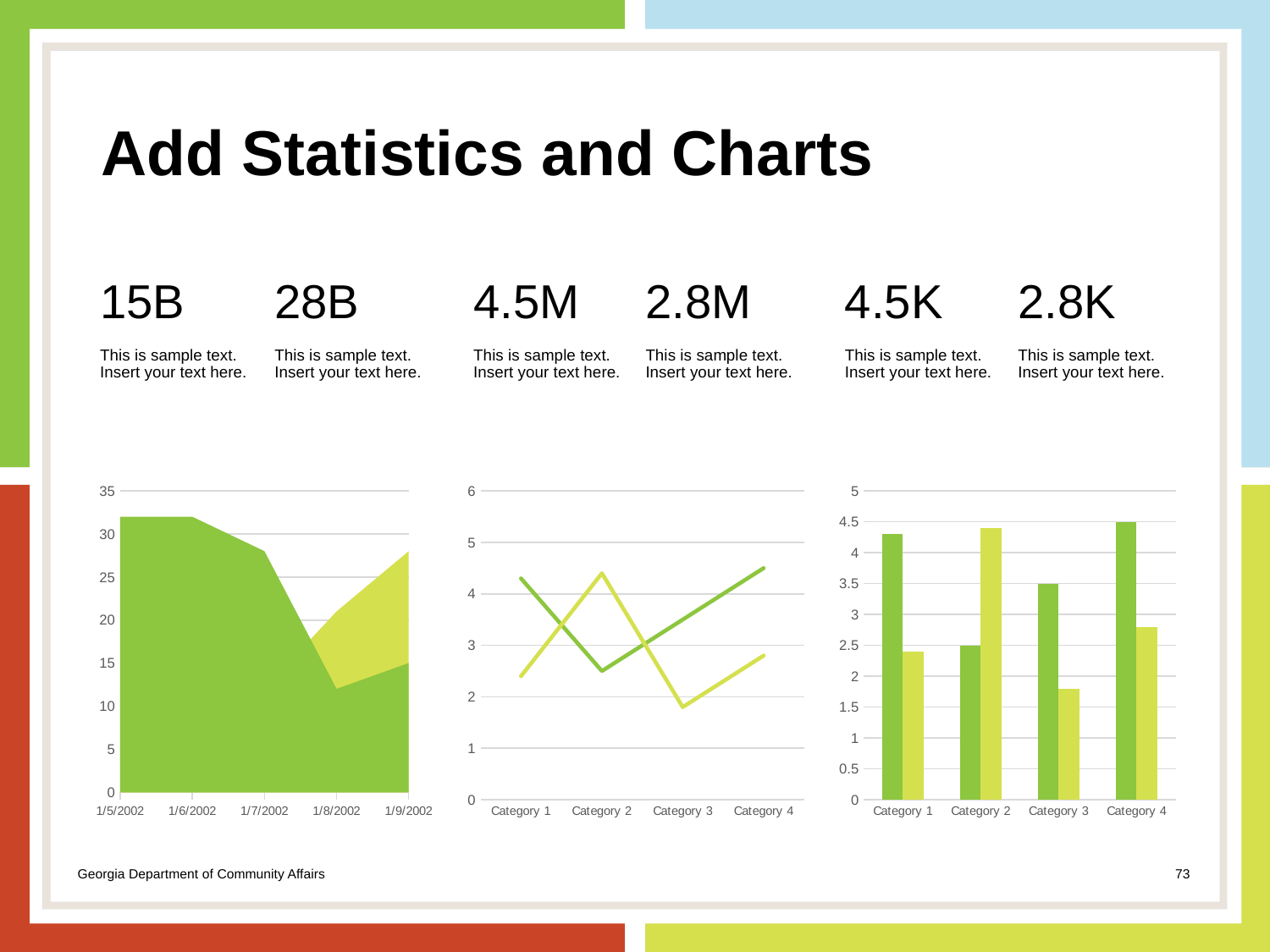
In the leftmost chart, is the value of the dark green area at 1/5/2002 greater or less than 30? greater In the rightmost chart, which bar is taller for Category 2, the dark green or the light green? light green In the middle chart, is the value of the light green line at Category 3 greater or less than 2? less In the rightmost chart, is the dark green bar for Category 1 greater or less than 4? greater What kind of chart is the leftmost chart on the slide? area chart In the middle chart, how many categories are shown on the x axis? 4 What kind of chart is the rightmost chart on the slide? bar chart In the leftmost chart, does the dark green area rise or fall from 1/6/2002 to 1/8/2002? fall In the middle chart, at which category is the light green line highest? Category 2 In the leftmost chart, how many dates are shown on the x axis? 5 What kind of chart is the middle chart on the slide? line chart